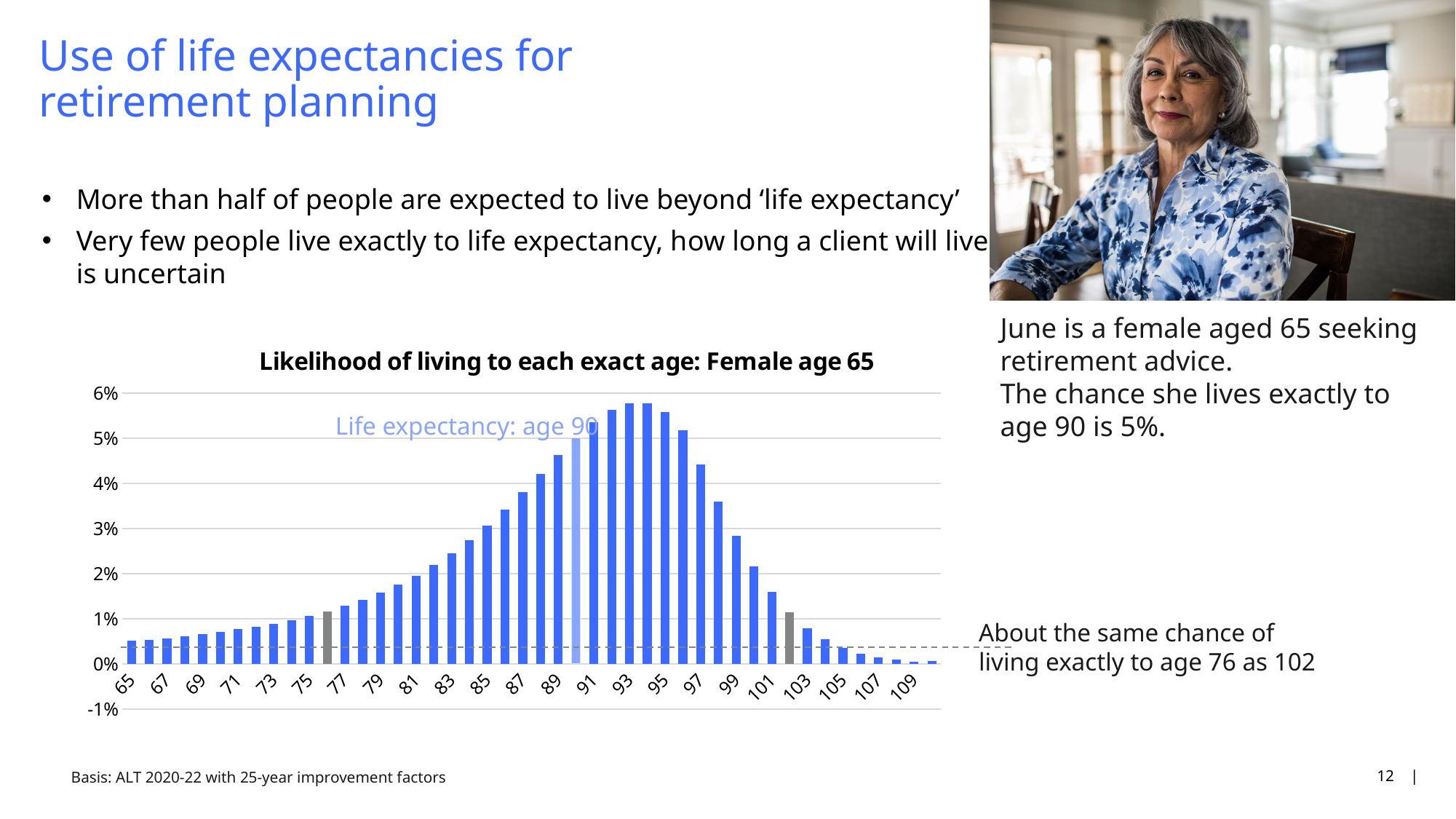
Is the value for age 97 greater or less than 4%? greater Which has the larger value, age 80 or age 90? age 90 Is the value for age 65 greater or less than 1%? less Is the value for age 85 greater or less than 2%? greater What kind of chart is shown on the slide? bar chart Do the values rise or fall from age 65 to age 90? rise Do the values rise or fall from age 95 to age 109? fall Which has the larger value, age 70 or age 100? age 100 What is the title of the chart? Likelihood of living to each exact age: Female age 65 According to the slide, what is the likelihood of living exactly to age 90? 5% What age is marked as the life expectancy on the chart? age 90